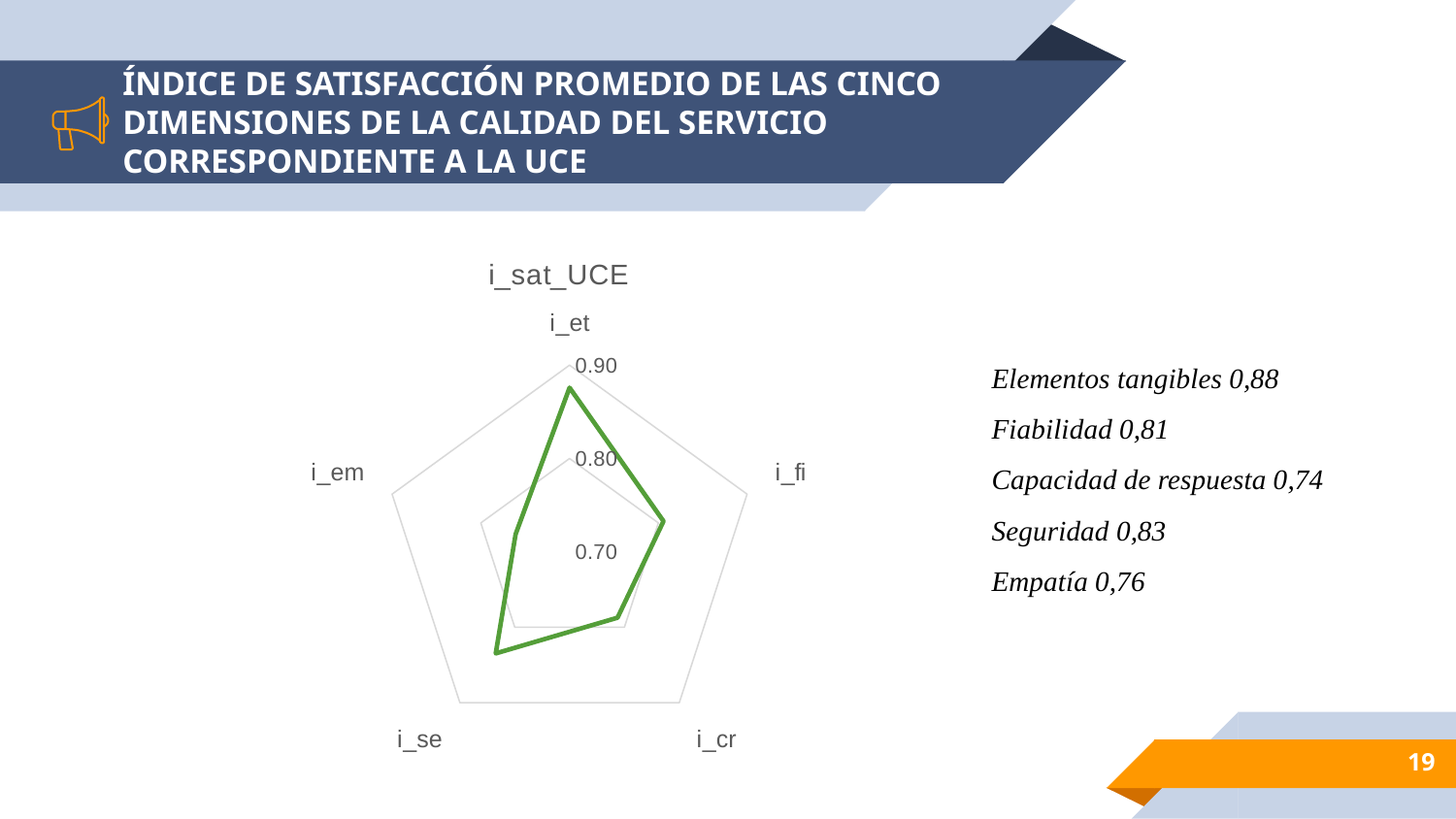
How many dimensions (axes) does the radar chart have? 5 According to the text on the slide, what is the satisfaction index for Seguridad? 0,83 Which is larger on the radar chart, the value for i_et or the value for i_cr? i_et Is the value for i_em greater or less than 0.80? less According to the text on the slide, what is the satisfaction index for Capacidad de respuesta? 0,74 What type of chart is shown on the slide? radar chart What is the title of the chart? i_sat_UCE Which dimension has the highest value on the radar chart? i_et Is the value for i_et greater or less than 0.80? greater According to the text on the slide, what is the satisfaction index for Elementos tangibles? 0,88 Is the value for i_se greater or less than 0.80? greater